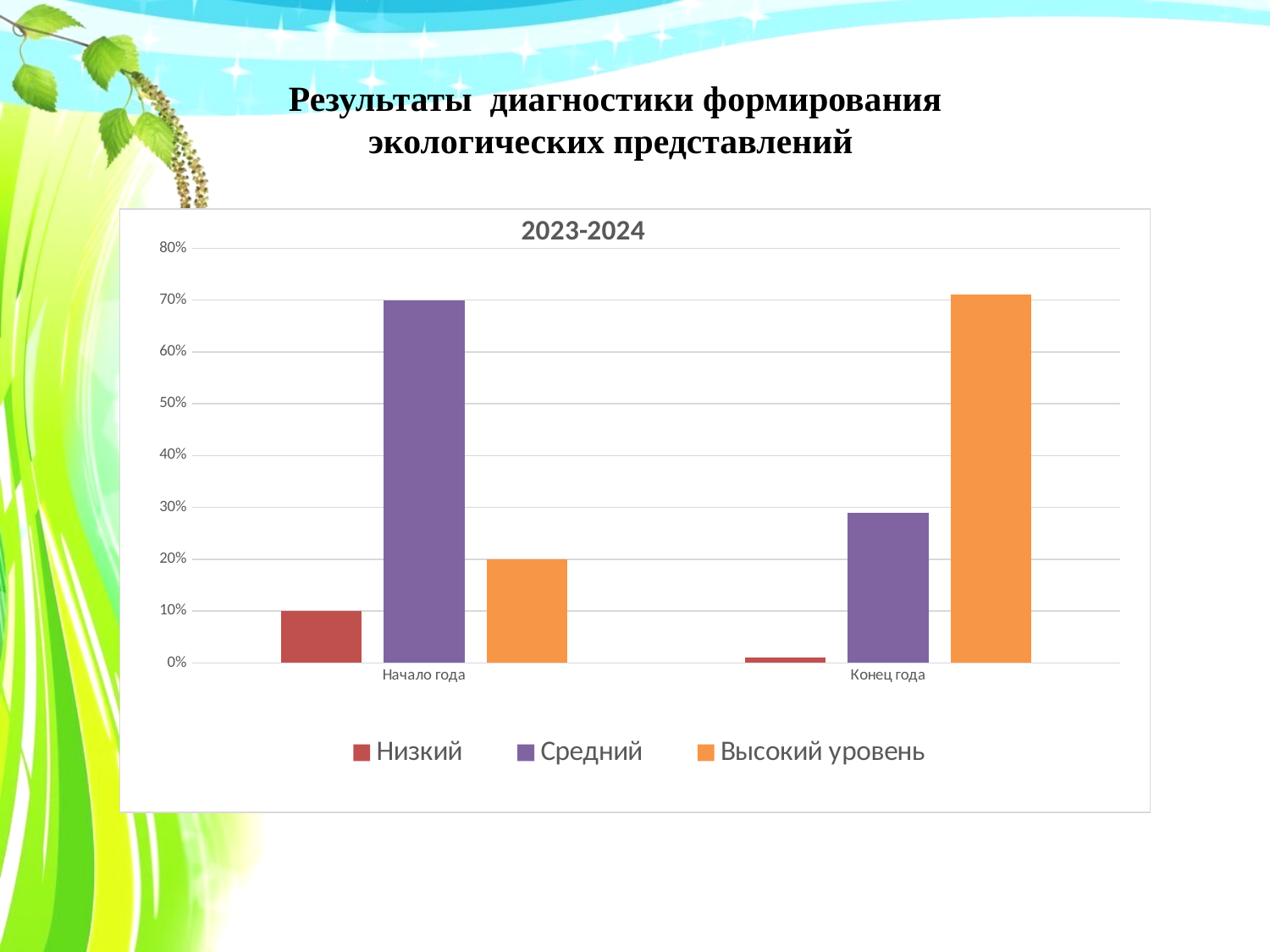
Which is larger: Средний at Начало года or Средний at Конец года? Средний at Начало года Which series has the highest value at Конец года? Высокий уровень Which series has the lowest value at Конец года? Низкий What is the value for Средний at Начало года? 70% How many categories are shown on the x axis? 2 How many series does the legend list? 3 What is the title of the chart? 2023-2024 What is the value for Высокий уровень at Начало года? 20% What is the value for Низкий at Начало года? 10% What kind of chart is shown on the slide? bar chart Is the value for Высокий уровень at Конец года greater or less than 60%? greater Is the value for Средний at Конец года greater or less than 40%? less